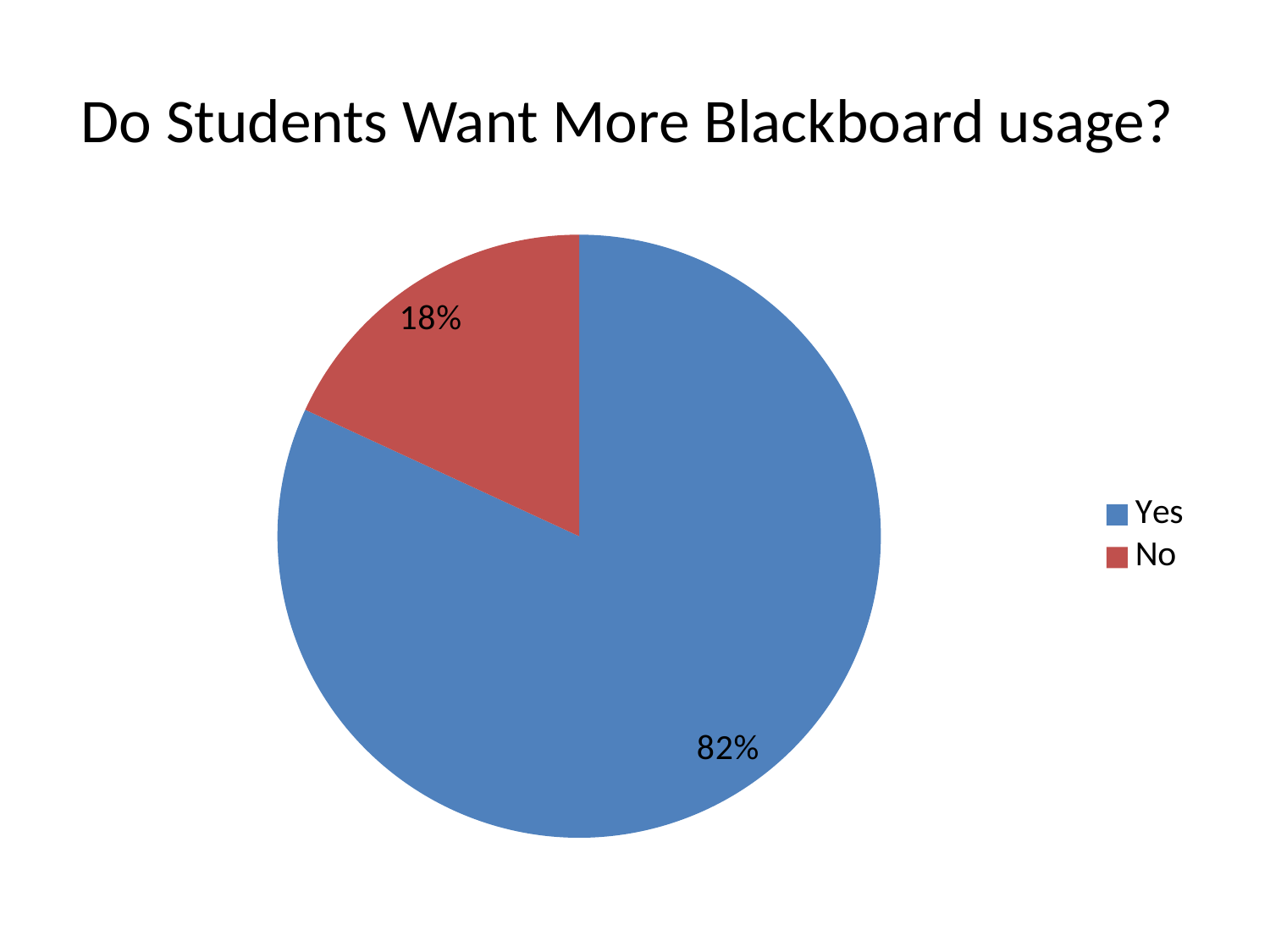
How many entries does the legend list? 2 What colour is the Yes slice? Blue What percentage of students answered No? 18% What percentage of students answered Yes? 82% Which response has the smallest share of the pie? No How many slices does the pie chart have? 2 What kind of chart is shown on the slide? Pie chart What is the title of the slide? Do Students Want More Blackboard usage? What is the difference in percentage points between the Yes and No slices? 64 Which slice is larger, Yes or No? Yes Which response has the largest share of the pie? Yes What share of the pie does the No slice represent? 18%